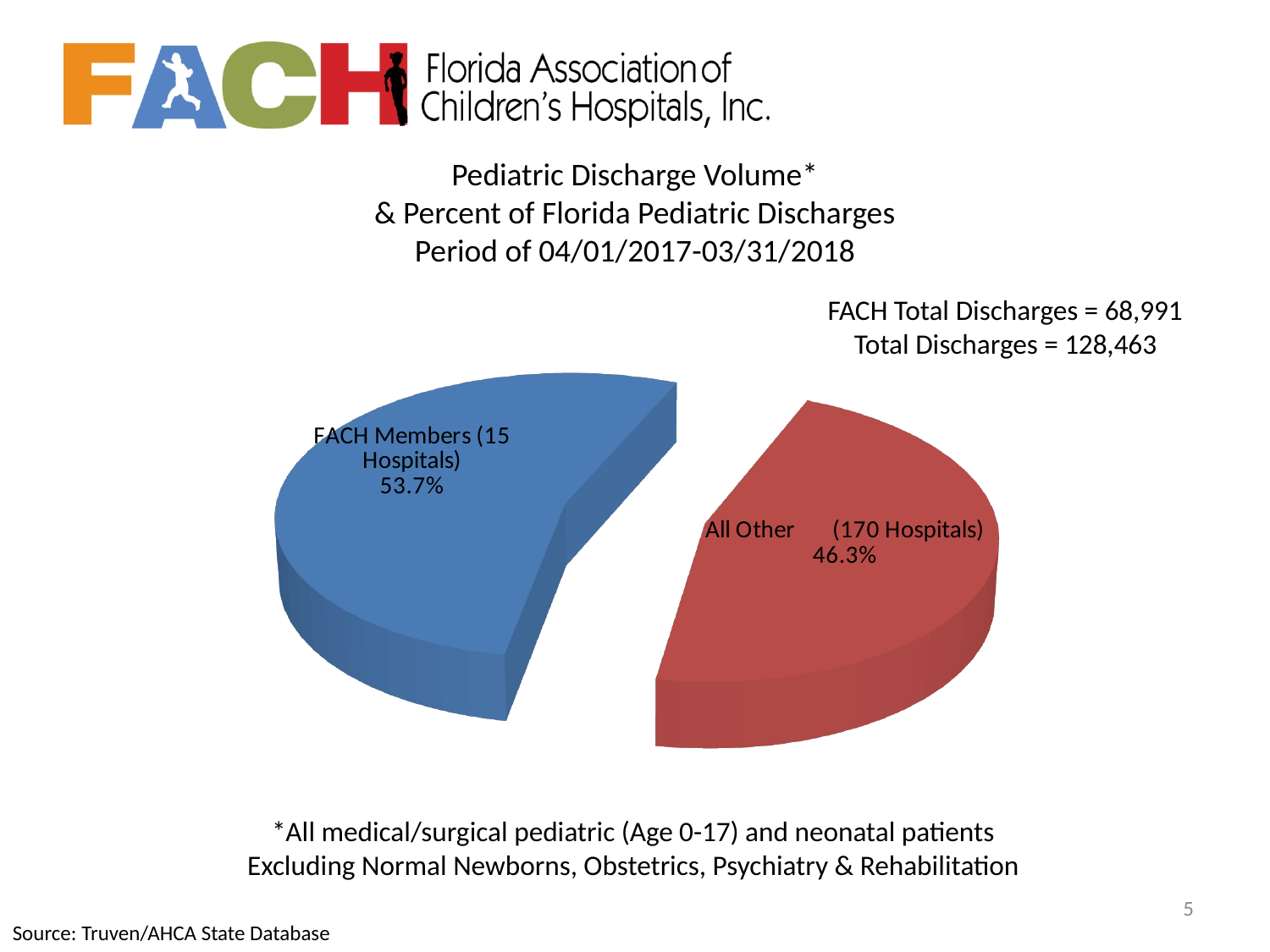
Is the share for FACH Members greater or less than 50%? greater What is the Total Discharges figure stated on the slide? 128,463 How many hospitals are included in the All Other slice? 170 Which slice of the pie is larger, FACH Members or All Other? FACH Members What percentage of Florida pediatric discharges is attributed to FACH Members? 53.7% What percentage of Florida pediatric discharges is attributed to All Other hospitals? 46.3% What is the difference in percentage points between the FACH Members share and the All Other share? 7.4 How many hospitals are included in the FACH Members slice? 15 What kind of chart is shown on the slide? Pie chart What is the FACH Total Discharges figure stated on the slide? 68,991 How many slices does the pie chart have? 2 Which category has the smallest share of the pie? All Other (170 Hospitals)